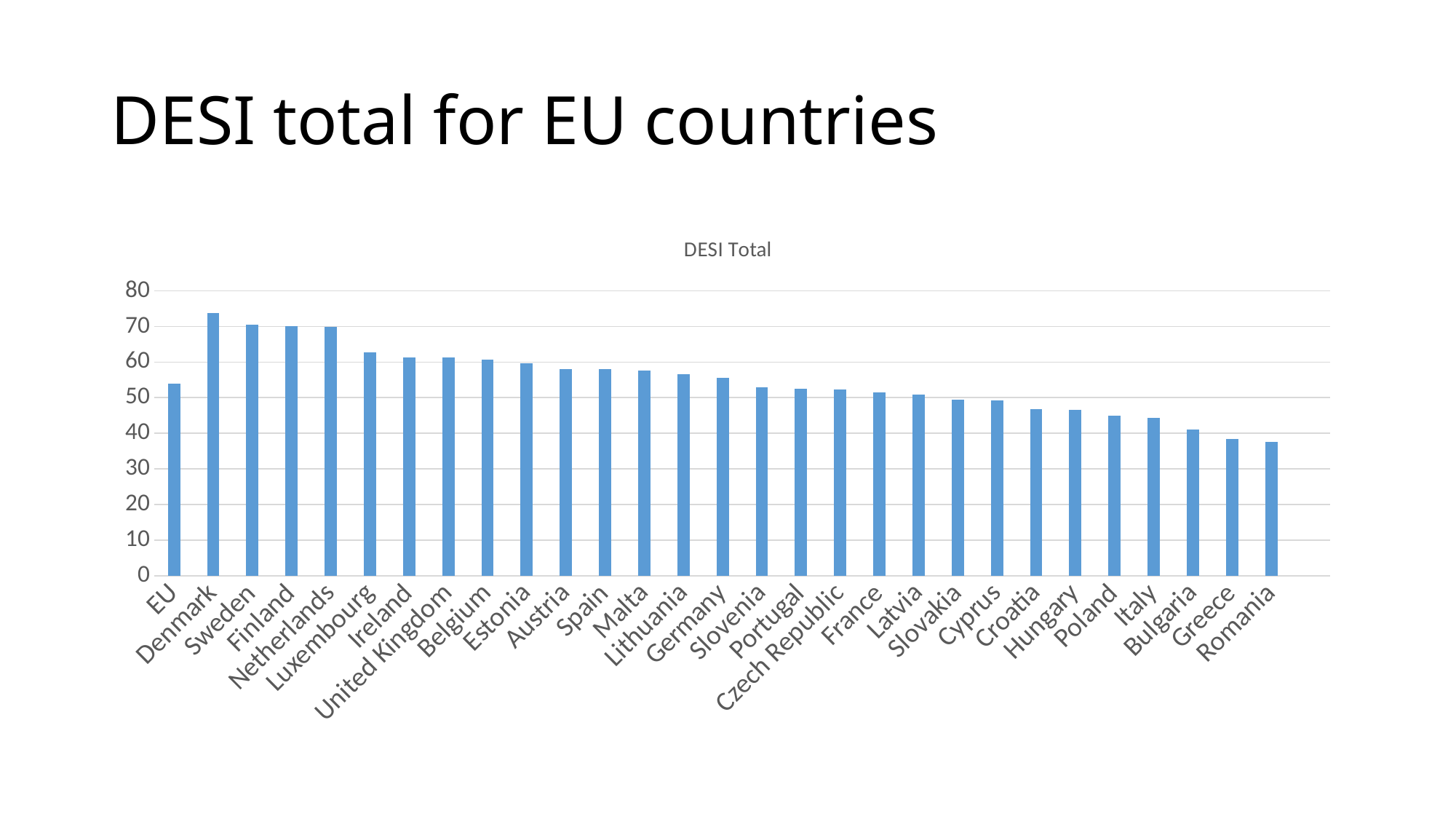
How many categories are plotted on the x axis? 29 Is the value for Poland greater or less than 50? less Which has a higher DESI total, Italy or Bulgaria? Italy Is the value for EU greater or less than 50? greater What kind of chart is shown on the slide? bar chart Which has a higher DESI total, Denmark or Sweden? Denmark Which country has the highest DESI total? Denmark What is the title of the chart? DESI Total Do the values generally rise or fall moving from Denmark to Romania along the x axis? fall Is the value for Romania greater or less than 40? less